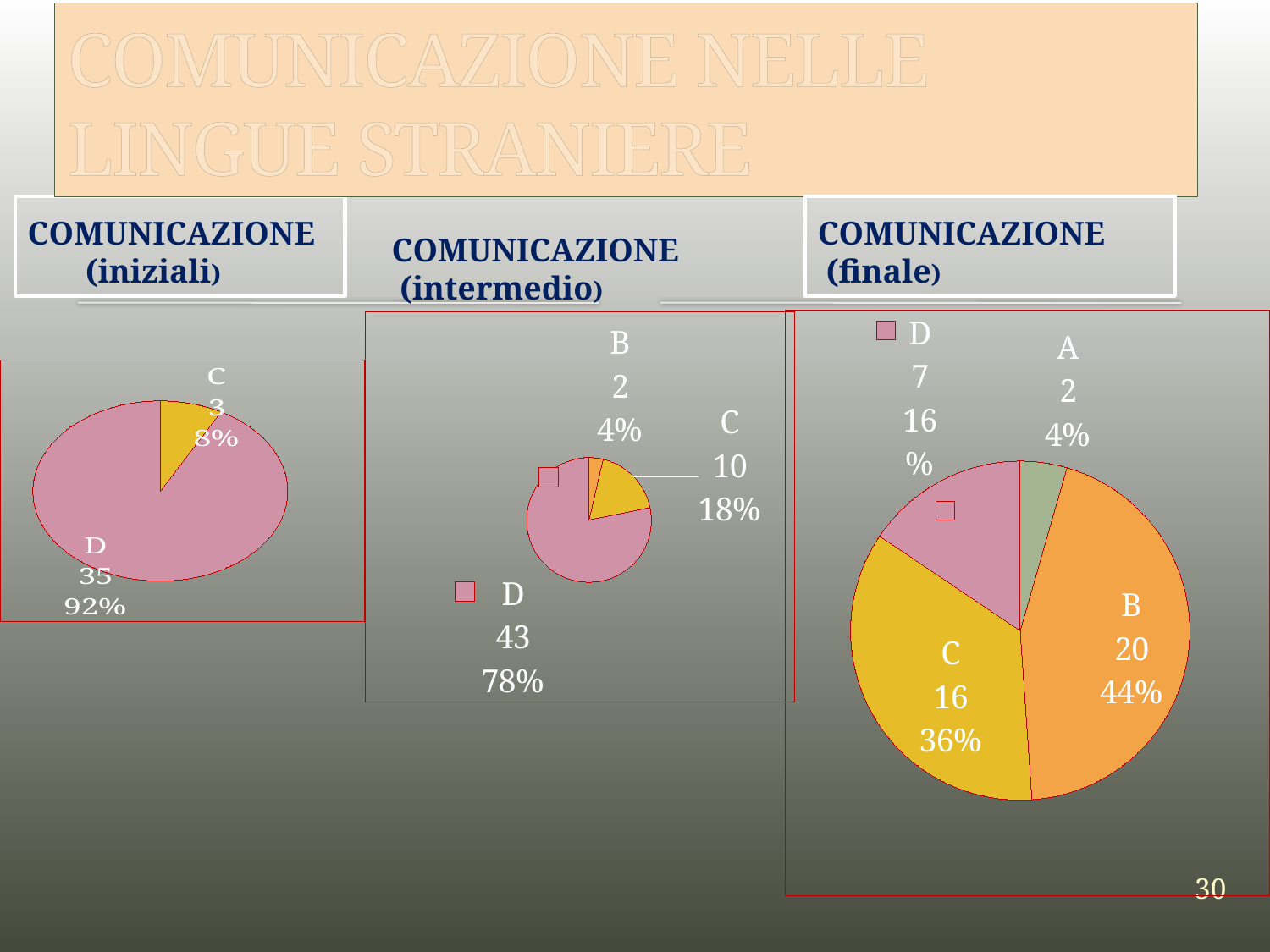
What type of chart is used for COMUNICAZIONE (finale)? Pie chart In the COMUNICAZIONE (intermedio) chart, which category has the smallest slice? B In the COMUNICAZIONE (iniziali) chart, what value is shown for category D? 35 In the COMUNICAZIONE (intermedio) chart, which category has the largest slice? D In the COMUNICAZIONE (intermedio) chart, what value is shown for category C? 10 In the COMUNICAZIONE (intermedio) chart, what percentage share does category D have? 78% In the COMUNICAZIONE (finale) chart, which category has the largest slice? B In the COMUNICAZIONE (finale) chart, how many categories are shown? 4 In the COMUNICAZIONE (finale) chart, what is the difference between the values for B and C? 4 In the COMUNICAZIONE (iniziali) chart, what percentage share does category C have? 8% In the COMUNICAZIONE (iniziali) chart, how many slices does the pie have? 2 In the COMUNICAZIONE (finale) chart, what value is shown for category B? 20